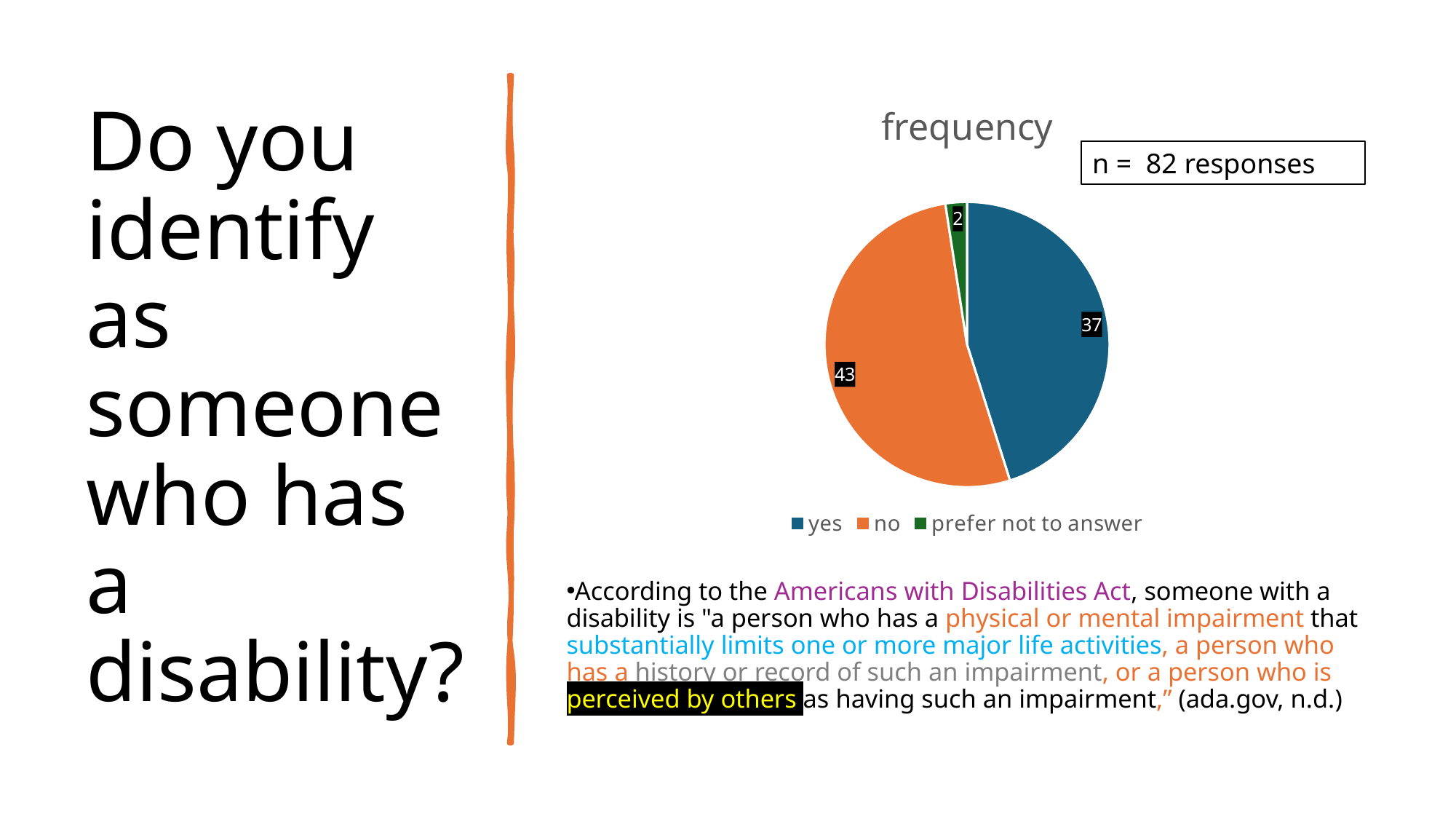
What is the total of all slices in the pie chart? 82 What colour is the 'prefer not to answer' slice? green How many responses are in the 'no' slice? 43 How many responses are in the 'prefer not to answer' slice? 2 What type of chart is shown on the slide? pie chart What is the difference between the 'no' and 'yes' counts? 6 What is the title of the chart? frequency Which is larger, the 'yes' slice or the 'no' slice? no How many categories does the pie chart have? 3 Which category has the smallest slice? prefer not to answer Which category has the largest slice? no How many responses are in the 'yes' slice? 37